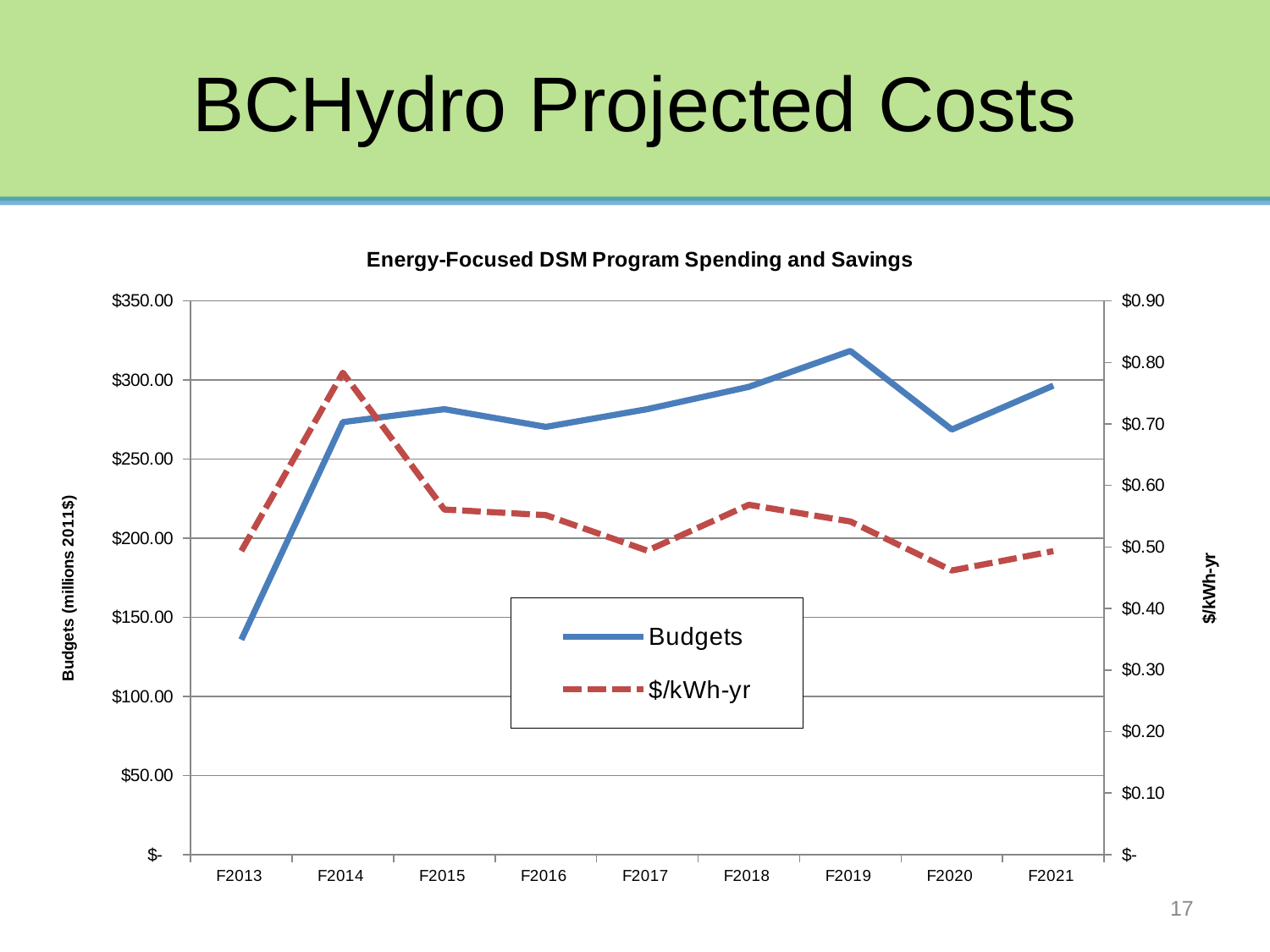
What kind of chart is shown on the slide? line chart In which fiscal year is the Budgets series highest? F2019 Is the Budgets value for F2019 greater or less than $300.00? greater How many fiscal years are plotted along the x axis? 9 In which fiscal year is the $/kWh-yr series lowest? F2020 Is the $/kWh-yr value for F2014 greater or less than $0.70? greater How many series does the legend list? 2 In which fiscal year is the Budgets series lowest? F2013 What is the title of the chart? Energy-Focused DSM Program Spending and Savings Is the Budgets value for F2013 greater or less than $150.00? less In which fiscal year is the $/kWh-yr series highest? F2014 Which is larger for the $/kWh-yr series, the value for F2015 or the value for F2017? F2015